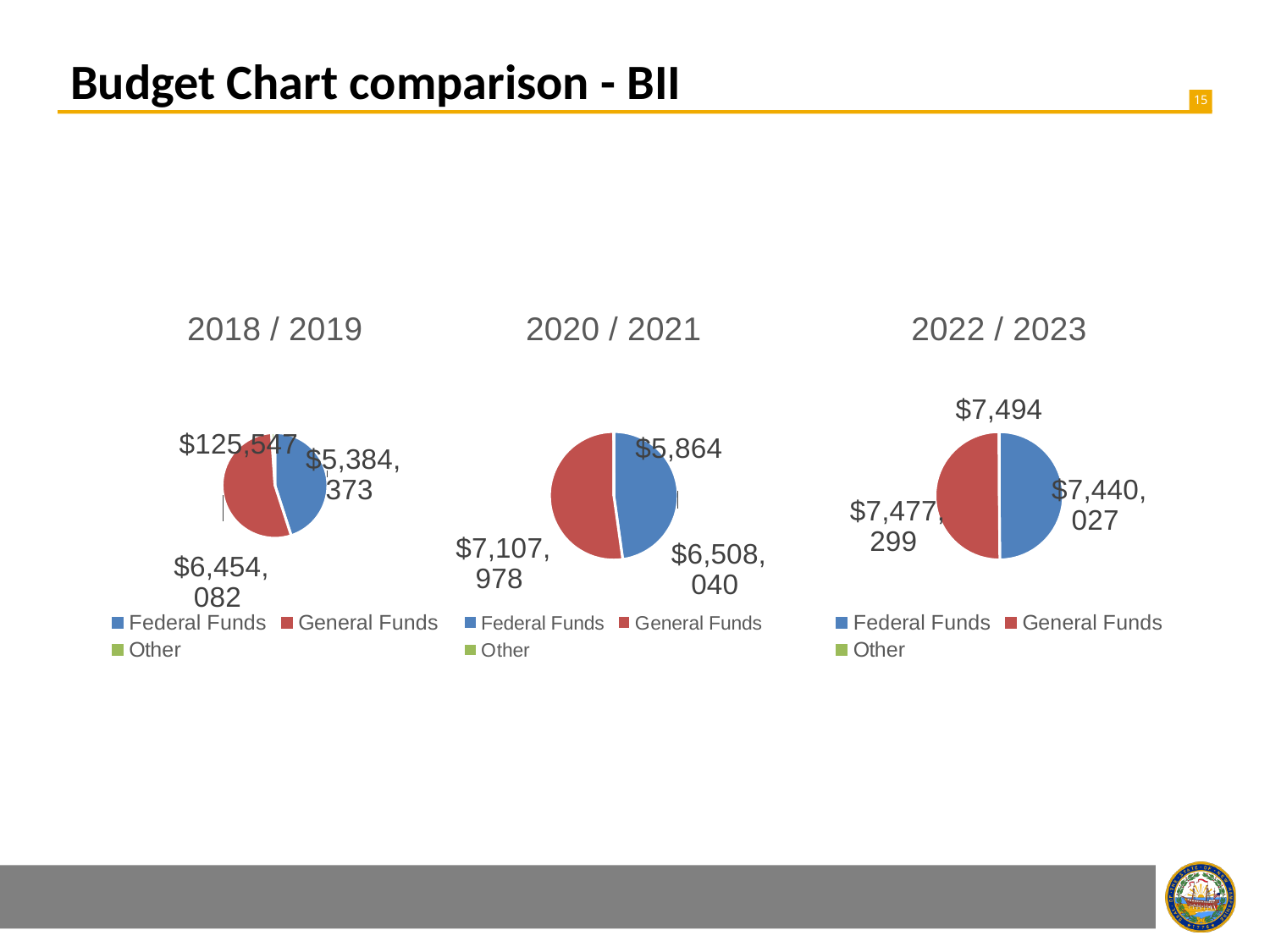
What kind of chart is used for the 2018 / 2019 budget? Pie chart In the 2018 / 2019 chart, what is the value for General Funds? $6,454,082 In the 2020 / 2021 chart, what is the value for General Funds? $7,107,978 In the 2018 / 2019 chart, what is the value for Federal Funds? $5,384,373 In the 2020 / 2021 chart, what is the value for Other? $5,864 In the 2020 / 2021 chart, what is the difference between General Funds and Federal Funds? $599,938 In the 2018 / 2019 chart, which category has the largest slice? General Funds In the 2022 / 2023 chart, what is the total of all three slices? $14,924,820 In the 2020 / 2021 chart, which category has the smallest slice? Other In the 2018 / 2019 chart, what is the value for Other? $125,547 In the 2022 / 2023 chart, what is the value for Federal Funds? $7,440,027 How many categories does the legend of the 2022 / 2023 chart list? 3